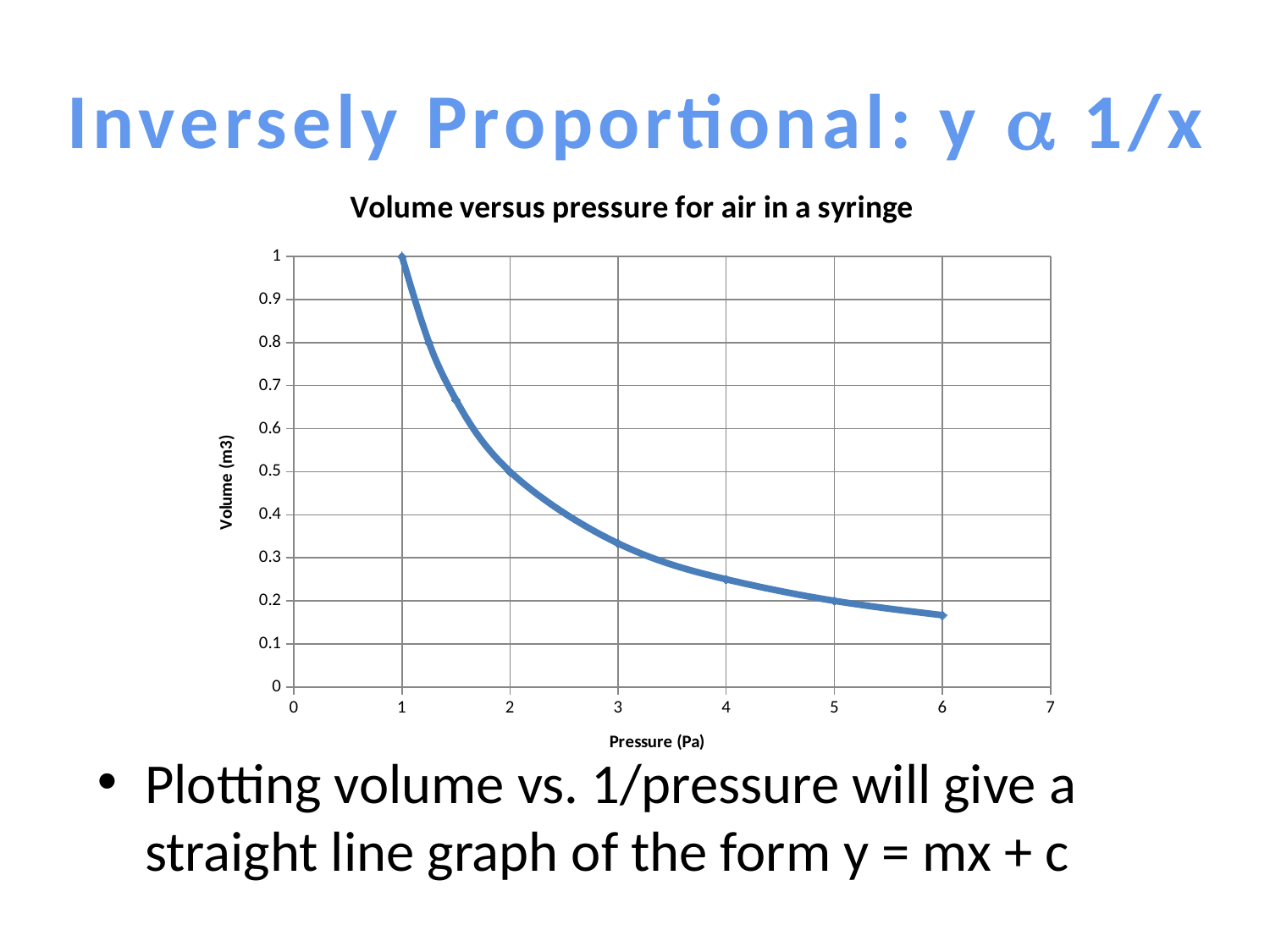
Which pressure gives the larger volume, 2 Pa or 4 Pa? 2 Pa What is the title of the chart? Volume versus pressure for air in a syringe What is the volume when the pressure is 2 Pa? 0.5 Is the volume at a pressure of 3 Pa greater or less than 0.4? less As pressure increases along the x axis, does the volume rise or fall? fall What kind of chart is shown on the slide? line chart What is the volume when the pressure is 5 Pa? 0.2 What is the label of the vertical axis? Volume (m3) What is the volume when the pressure is 1 Pa? 1 Is the volume at a pressure of 6 Pa greater or less than 0.2? less Is the volume at a pressure of 4 Pa greater or less than 0.2? greater At which plotted pressure is the volume highest? 1 Pa